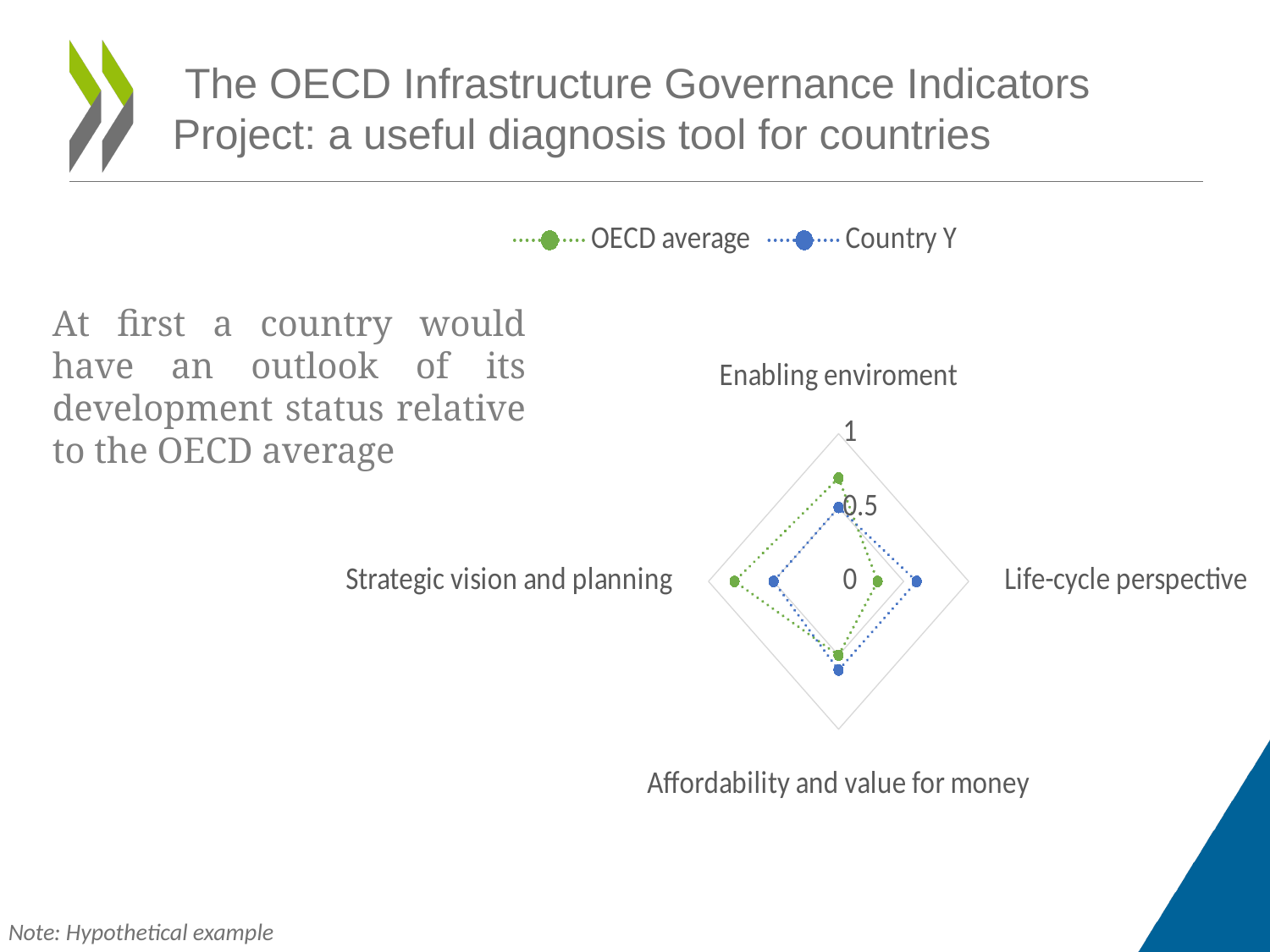
How many series does the chart's legend list? 2 Is the OECD average value for Enabling enviroment greater or less than 0.5? greater What kind of chart is shown on the slide? Radar chart What colour is used for the Country Y series? Blue Is the OECD average value for Strategic vision and planning greater or less than 0.5? greater For Enabling enviroment, which series has the larger value, OECD average or Country Y? OECD average For the OECD average series, which category has the lowest value? Life-cycle perspective For Life-cycle perspective, which series has the larger value, OECD average or Country Y? Country Y For Strategic vision and planning, which series has the larger value, OECD average or Country Y? OECD average Which series are listed in the chart's legend? OECD average and Country Y Is the OECD average value for Life-cycle perspective greater or less than 0.5? less How many categories (axes) does the radar chart have? 4